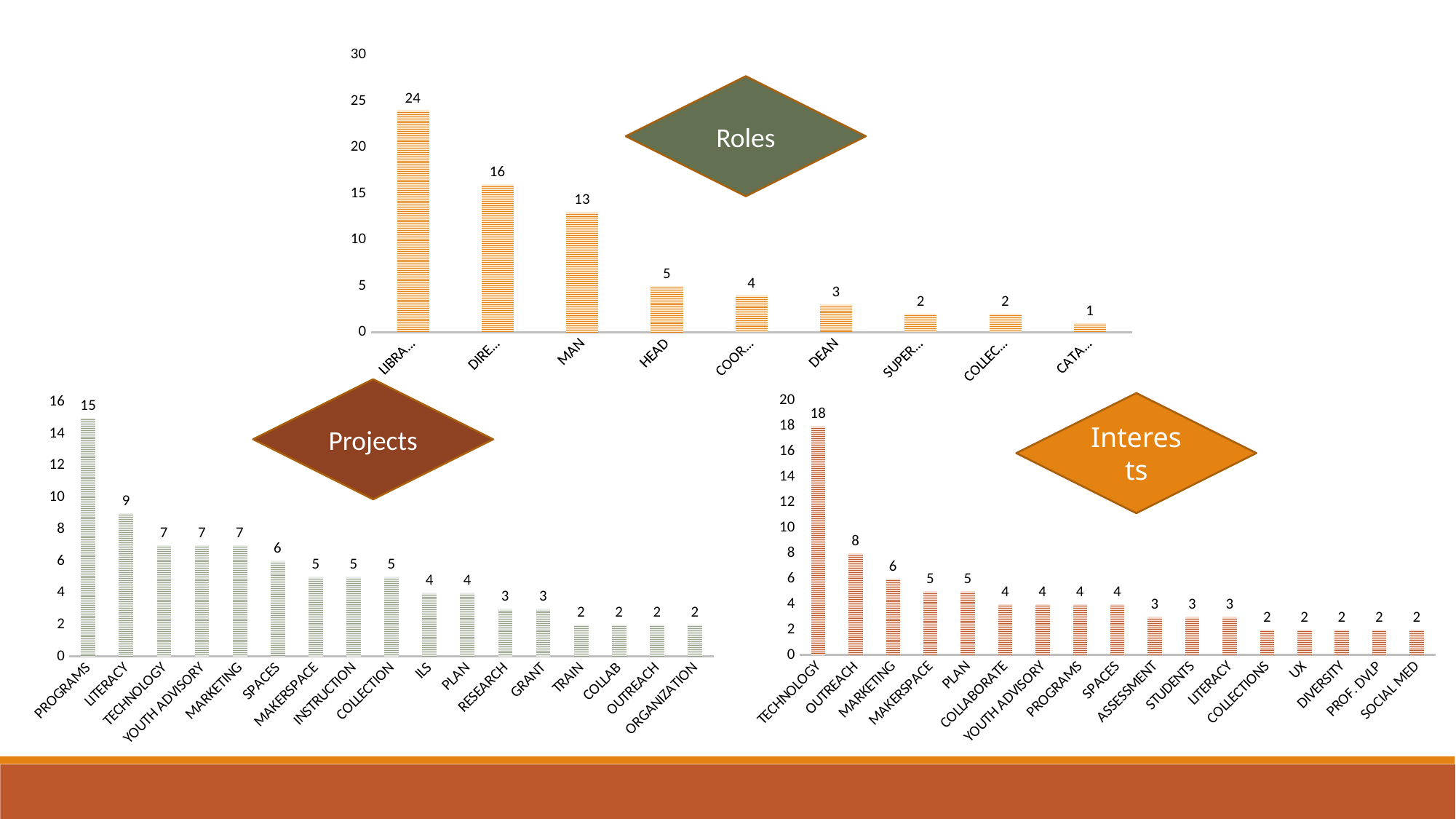
In the Interests chart, what is the difference between TECHNOLOGY and MARKETING? 12 In the Roles chart, what is the value for HEAD? 5 In the Roles chart, what is the value for DEAN? 3 In the Interests chart, what is the value for OUTREACH? 8 In the Projects chart, which is larger, MAKERSPACE or ILS? MAKERSPACE In the Projects chart, what is the value for LITERACY? 9 In the Projects chart, which category has the highest value? PROGRAMS In the Interests chart, which category has the highest value? TECHNOLOGY How many bars are in the Roles chart? 9 In the Roles chart, what is the highest value shown? 24 In the Projects chart, what is the difference between PROGRAMS and SPACES? 9 What type of chart is the Interests chart? Bar chart